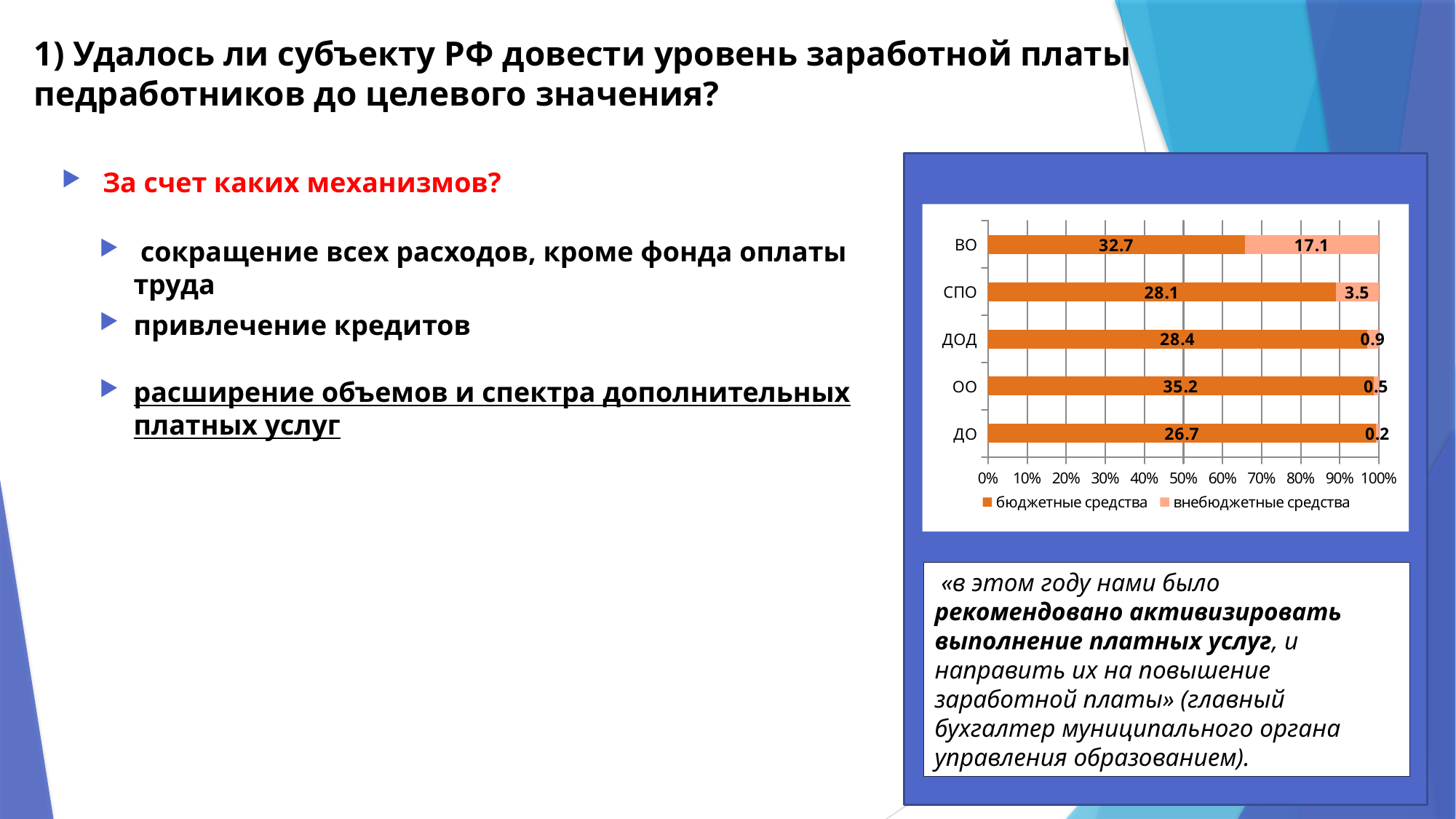
What kind of chart is shown on the slide? Stacked bar chart Which category has the highest value for бюджетные средства? ОО Which is larger: внебюджетные средства for ДОД or for ОО? ДОД What is the total of the two values labelled on the ВО bar? 49.8 What is the value of бюджетные средства for ВО? 32.7 Which category has the lowest value for бюджетные средства? ДО What is the value of бюджетные средства for ДО? 26.7 How many series does the legend list? 2 What is the difference between the бюджетные средства values for ОО and ДО? 8.5 Which category has the highest value for внебюджетные средства? ВО What is the value of внебюджетные средства for СПО? 3.5 How many categories are shown on the chart? 5